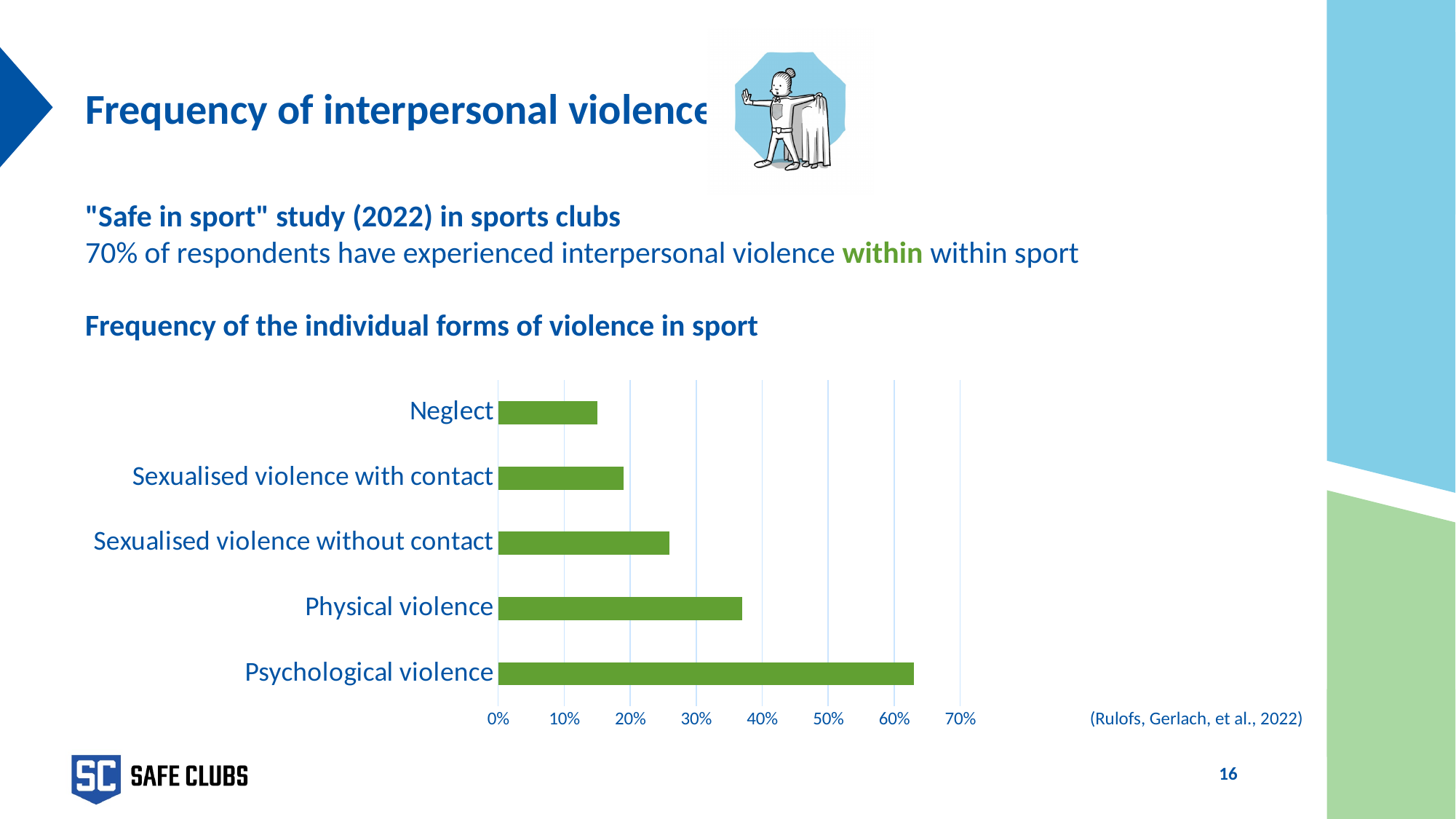
Is the value for Sexualised violence with contact greater or less than 30%? less Which form of violence has the highest frequency in the chart? Psychological violence Is the value for Neglect greater or less than 20%? less Is the value for Sexualised violence without contact greater or less than 20%? greater How many forms of violence are plotted in the chart? 5 What is the title given above the chart? Frequency of the individual forms of violence in sport What kind of chart is shown on the slide? bar chart Which is larger, the value for Physical violence or the value for Sexualised violence without contact? Physical violence Which form of violence has the lowest frequency in the chart? Neglect